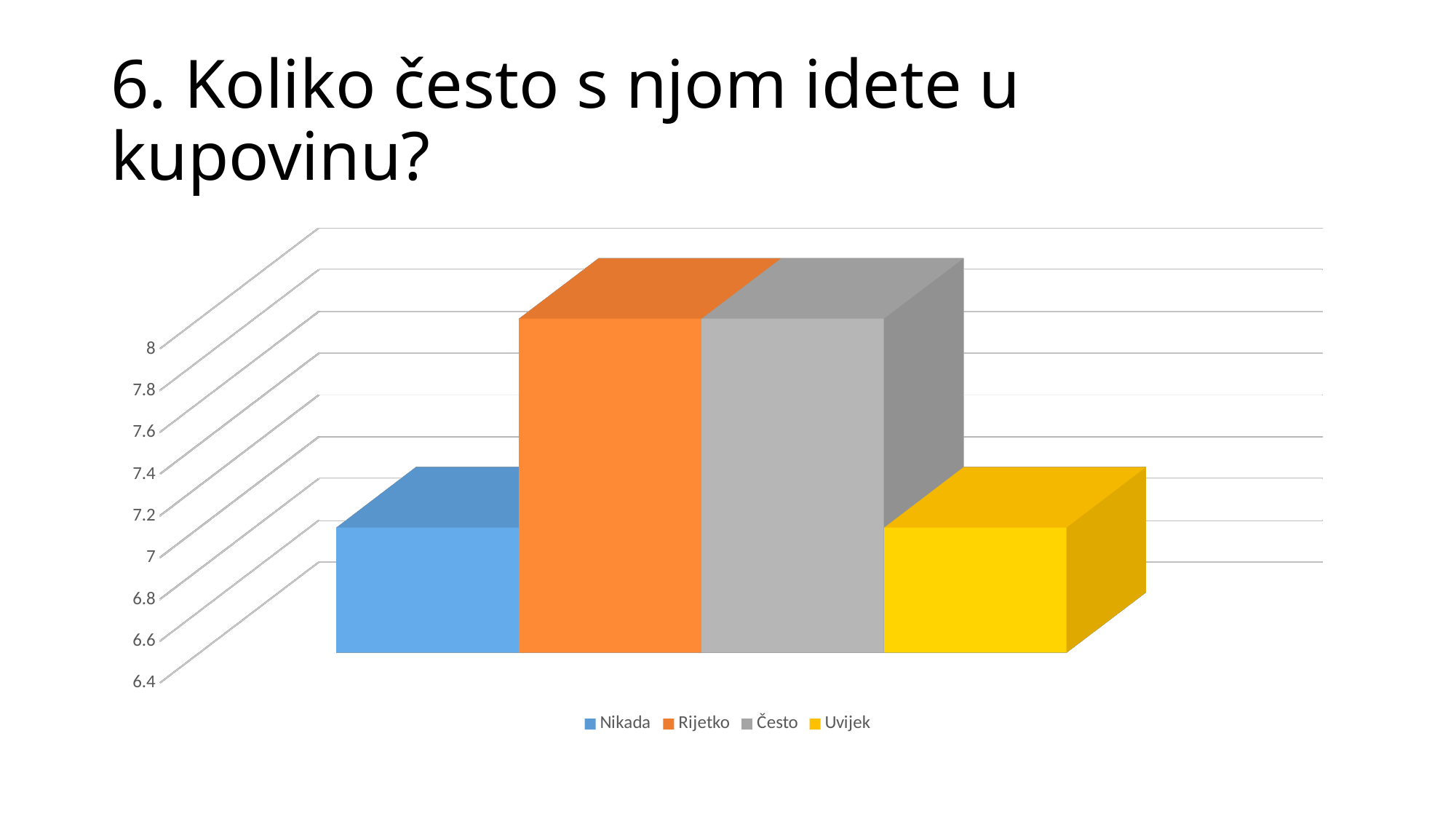
Which is larger, the value for Rijetko or the value for Nikada? Rijetko Is the value for Uvijek greater or less than 7.6? less Is the value for Često greater or less than 7.6? greater Is the value for Nikada greater or less than 7.4? less What is the title of the slide containing the chart? 6. Koliko često s njom idete u kupovinu? How many entries does the chart legend list? 4 What colour is the bar for Rijetko? orange How many bars are plotted in the chart? 4 Which is larger, the value for Često or the value for Uvijek? Često What kind of chart is shown on the slide? bar chart